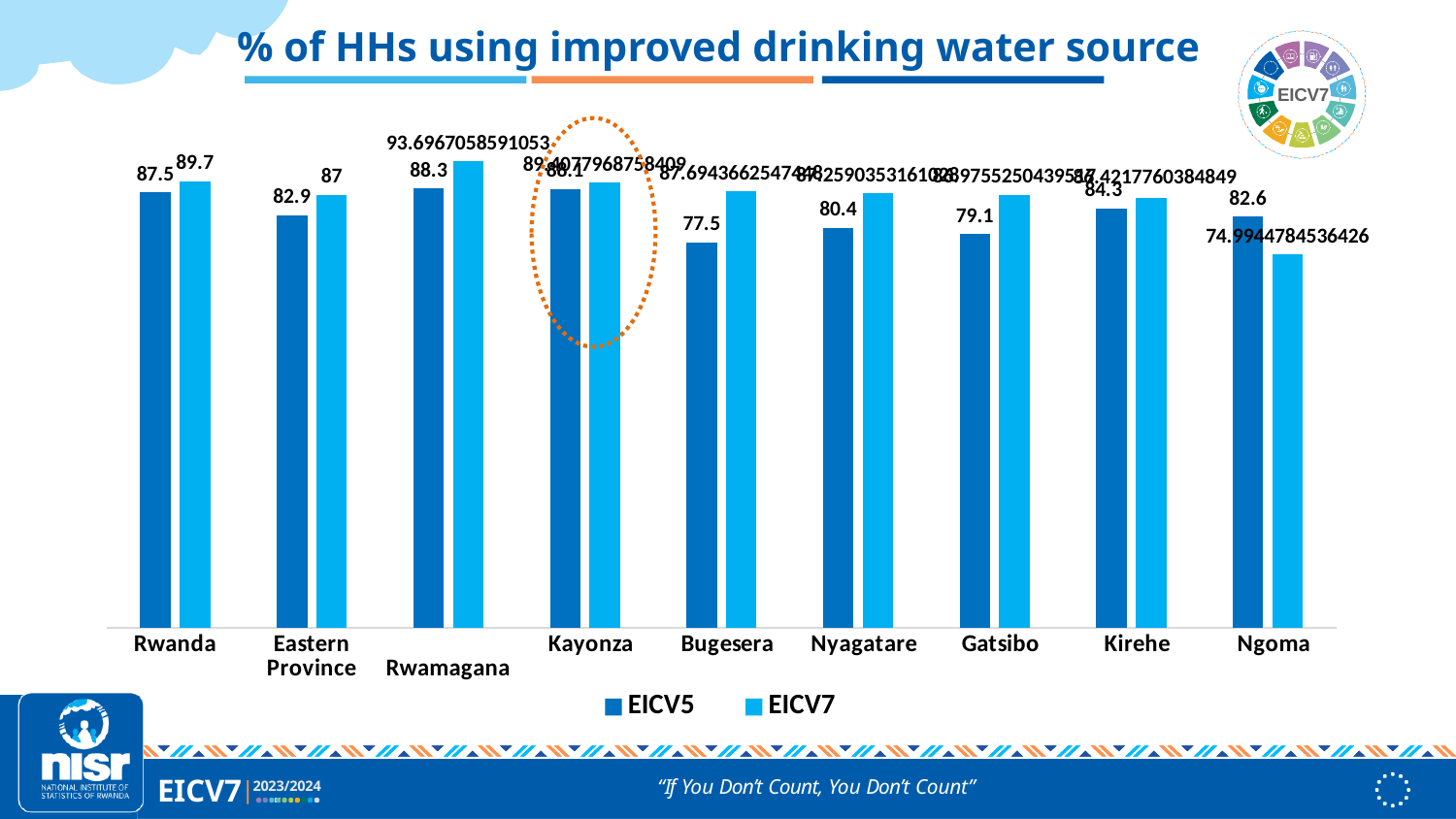
What is the difference between the EICV7 and EICV5 values for Rwanda? 2.2 What is the EICV7 value for Ngoma? 74.9944784536426 Which category has the lowest EICV5 value? Bugesera How many categories are shown on the x axis? 9 What is the EICV5 value for Rwanda? 87.5 How many series does the legend list? 2 Which district's bars are highlighted with a dotted orange circle? Kayonza For Ngoma, which is larger: the EICV5 value or the EICV7 value? EICV5 What is the EICV5 value for Bugesera? 77.5 What is the EICV7 value for Rwamagana? 93.6967058591053 What is the EICV7 value for Eastern Province? 87 Which category has the highest EICV7 value? Rwamagana